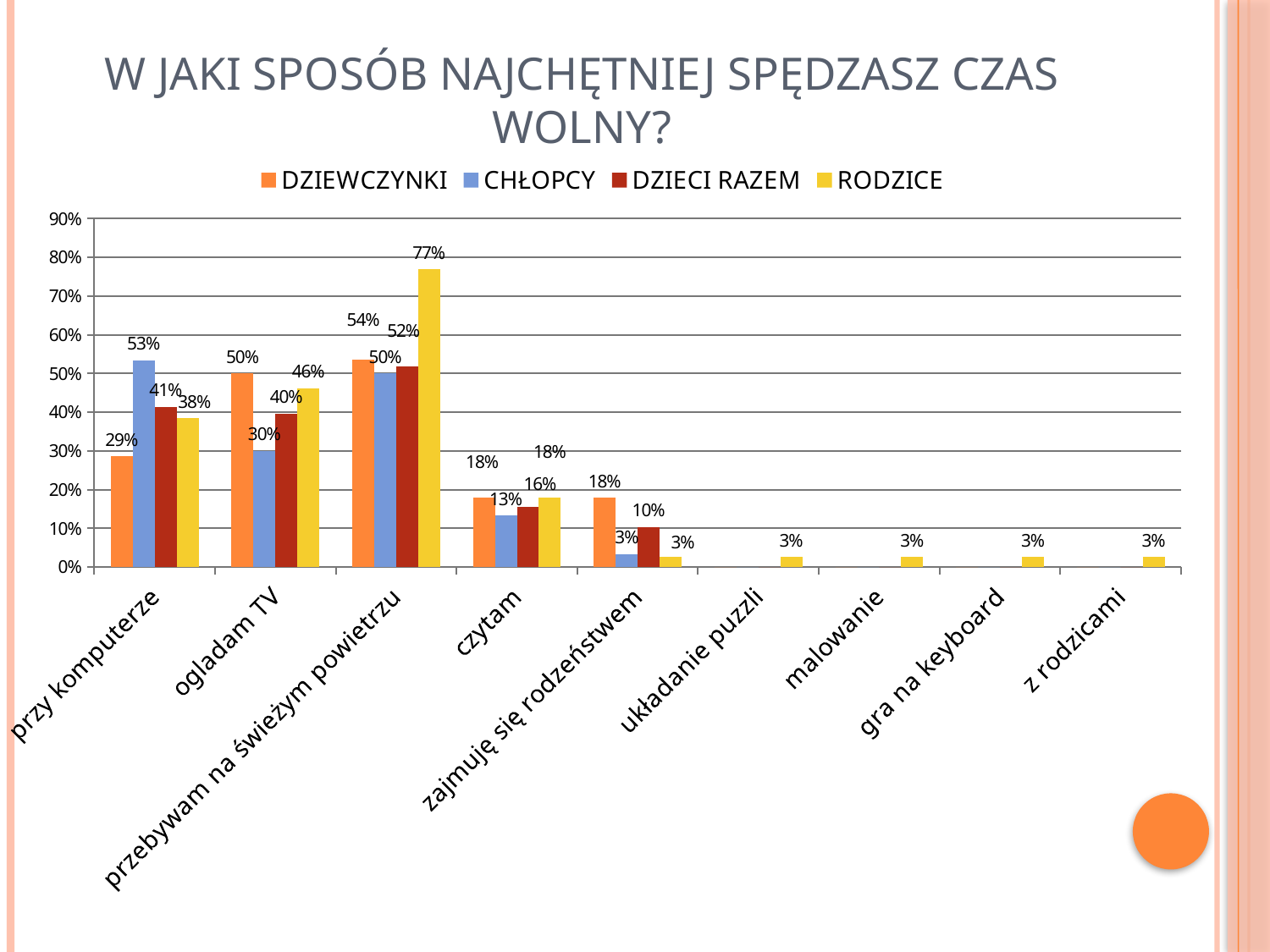
What is the value for DZIECI RAZEM in the category 'oglądam TV'? 40% What is the value for CHŁOPCY in the category 'przy komputerze'? 53% Which category has the lowest value for DZIEWCZYNKI among those where DZIEWCZYNKI has a bar? czytam and zajmuję się rodzeństwem (both 18%) Which series is shown in yellow in the legend? RODZICE What is the difference between the RODZICE value and the DZIEWCZYNKI value in the category 'przebywam na świeżym powietrzu'? 23% What is the value for RODZICE in the category 'przebywam na świeżym powietrzu'? 77% How many series does the legend list? 4 What type of chart is shown on the slide? bar chart Which category has the highest value for RODZICE? przebywam na świeżym powietrzu What is the value for RODZICE in the category 'malowanie'? 3% In the category 'oglądam TV', which is larger: the value for DZIEWCZYNKI or the value for CHŁOPCY? DZIEWCZYNKI How many categories are shown on the x axis? 9